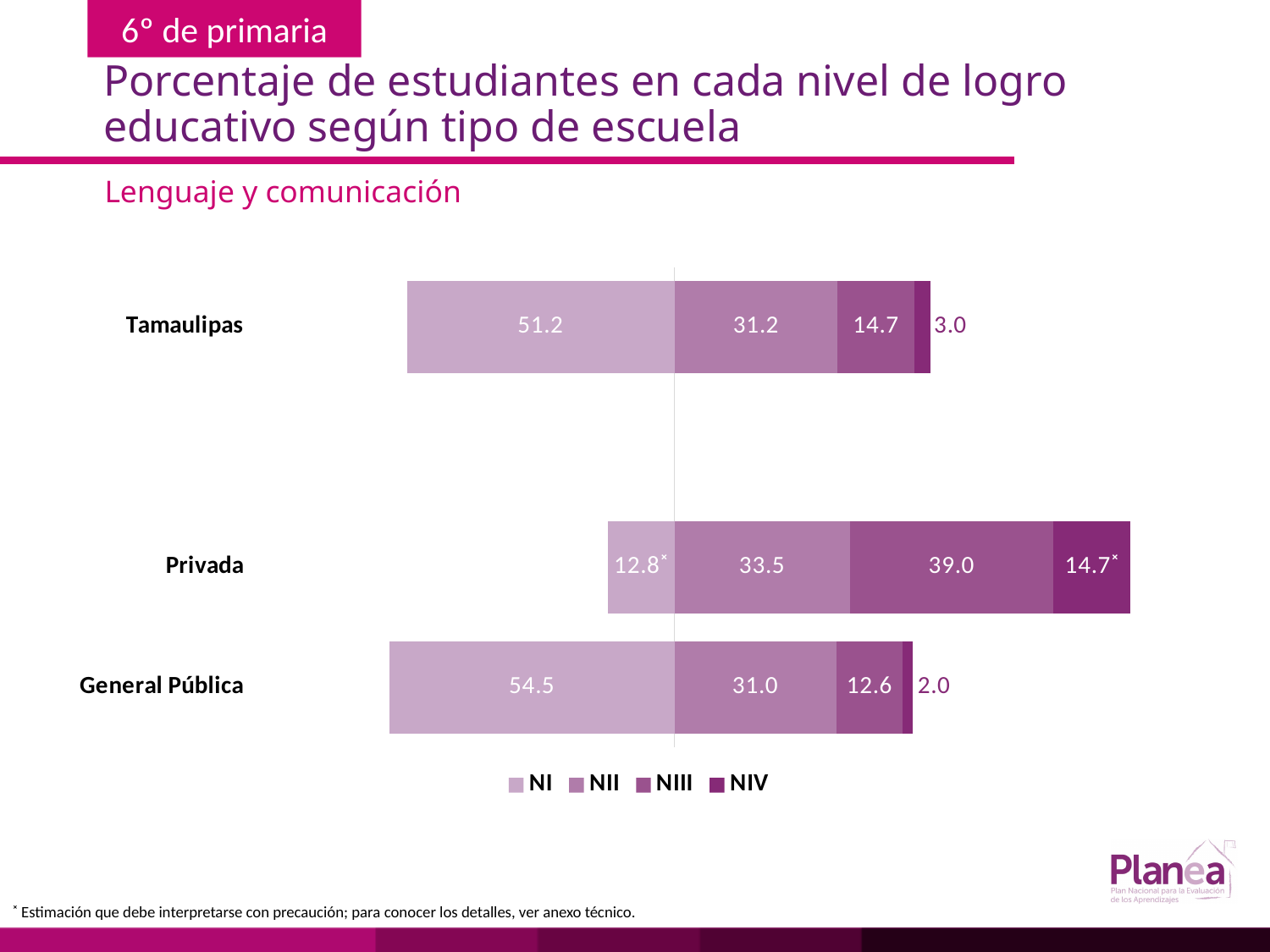
What percentage of Tamaulipas students are at level NI? 51.2 What kind of chart is shown on the slide? Stacked bar chart Which category has the lowest NIV value? General Pública What is the total of the Privada bar? 100.0 Which is larger, the NIII value for Tamaulipas or the NIII value for General Pública? Tamaulipas What is the NIII value for Privada schools? 39.0 How many school categories are shown in the chart? 3 What is the NII value for Tamaulipas? 31.2 What is the difference between the NI values of General Pública and Privada? 41.7 What is the NIV value for General Pública? 2.0 Which school type has the highest NI value? General Pública How many series does the legend list? 4